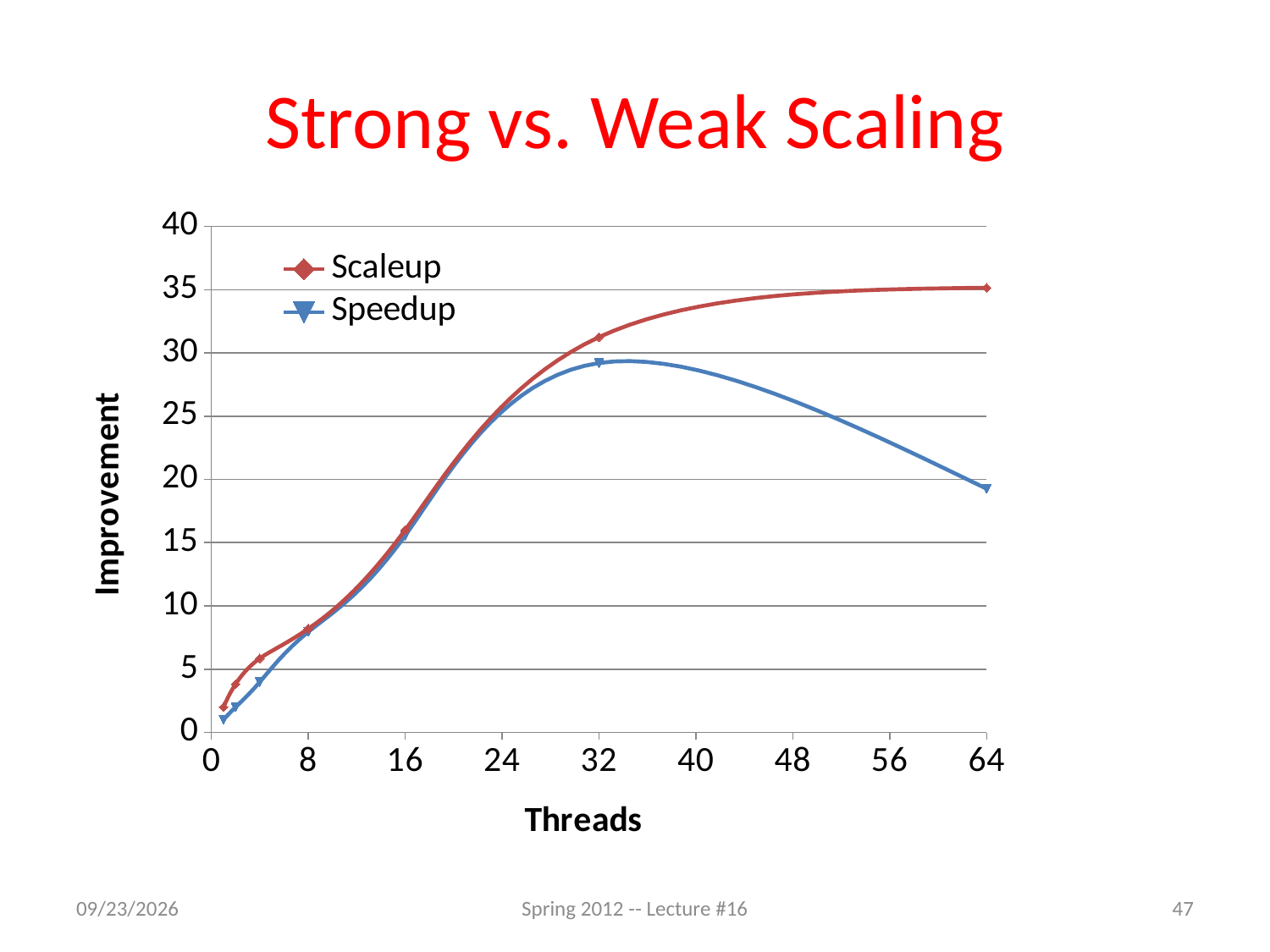
How many series does the legend list? 2 Is the Speedup value at 64 threads greater or less than 25? less Does the Speedup series rise or fall between 32 and 64 threads? Fall Is the Speedup value at 32 threads greater or less than 30? less How many data points are plotted for the Speedup series? 7 At how many threads does the Speedup series reach its highest value? 32 What are the names of the two series in the legend? Scaleup and Speedup Is the Scaleup value at 64 threads greater or less than 30? greater What kind of chart is shown on the slide? Line chart What is the label of the y axis? Improvement At 64 threads, which series has the larger value, Scaleup or Speedup? Scaleup